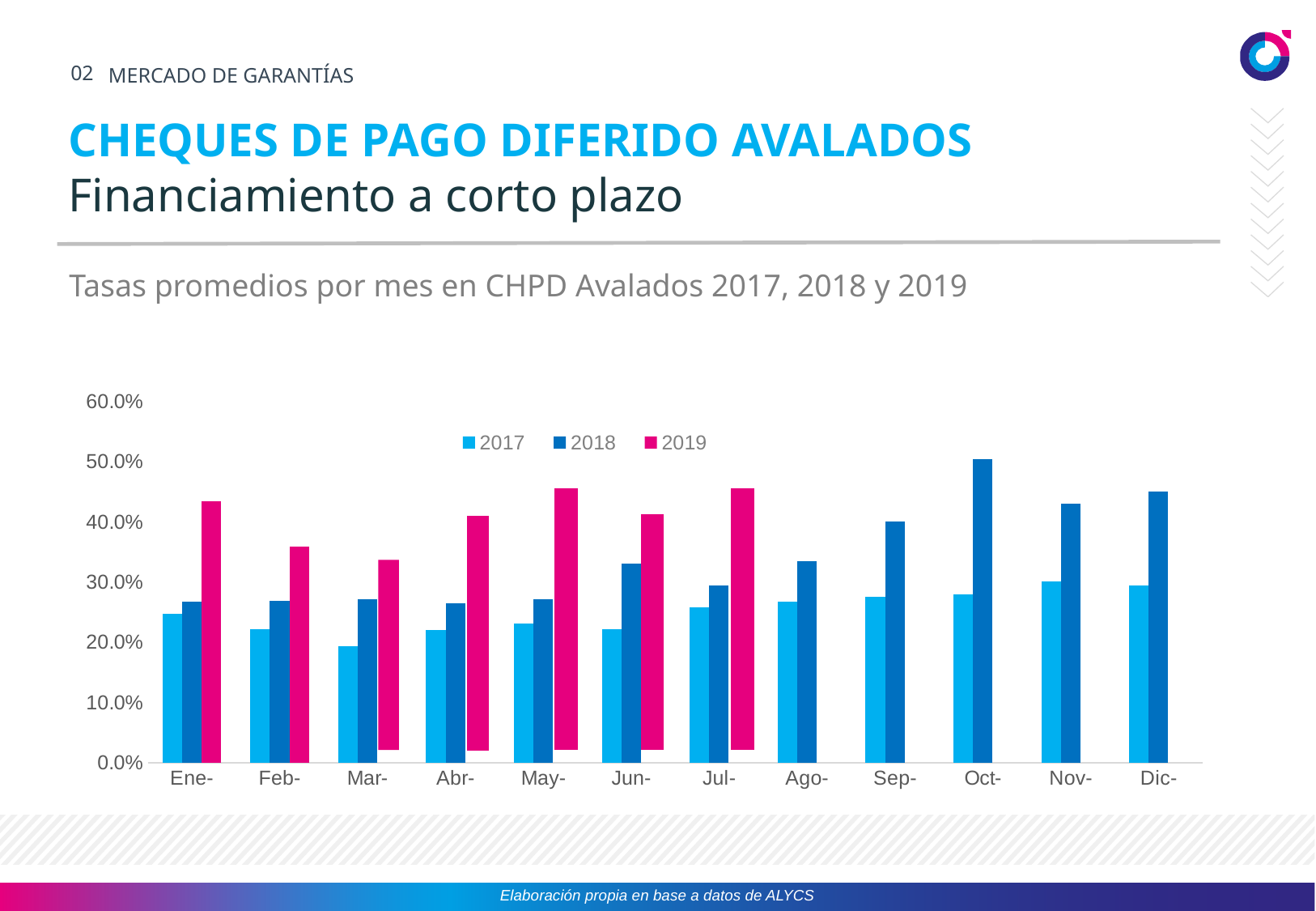
In which month is the 2017 value lowest? Mar- For how many months is a 2019 bar plotted? 7 Do the 2018 values rise or fall from Ago- to Oct-? rise Is the 2018 value for Oct- greater or less than 40.0%? greater How many months are shown on the x axis? 12 What kind of chart is shown on the slide? Bar chart How many series does the legend list? 3 Which is larger, the 2017 value for Ene- or the 2017 value for Nov-? Nov- Is the 2019 value for May- greater or less than 40.0%? greater In which month is the 2018 value highest? Oct- Is the 2017 value for Mar- greater or less than 20.0%? less For Ene-, which series has the larger value, 2018 or 2019? 2019